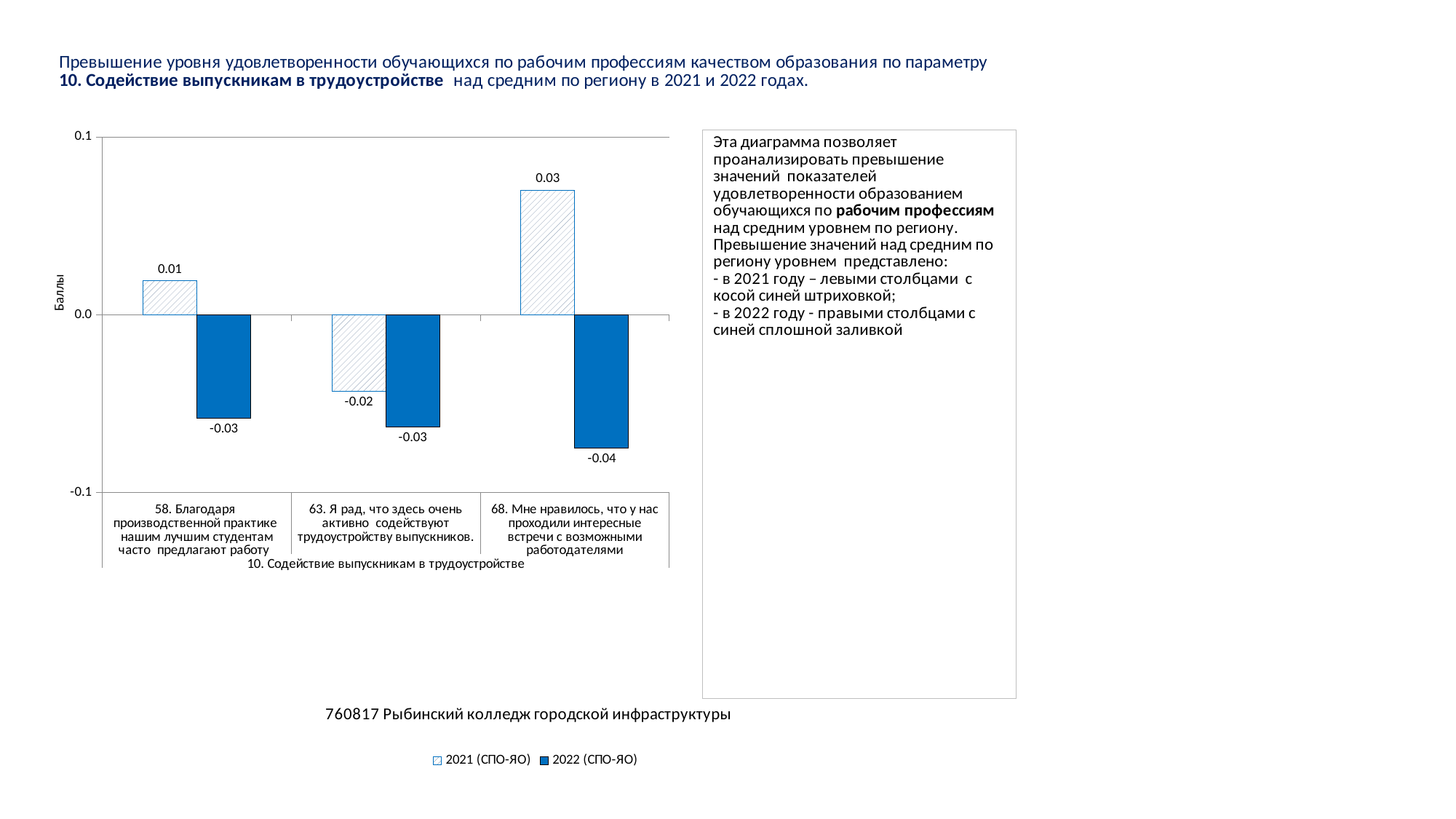
What type of chart is shown on the slide? Bar chart What is the difference between the 2021 and 2022 values for category 68? 0.07 For category 63, which series has the larger value, 2021 (СПО-ЯО) or 2022 (СПО-ЯО)? 2021 (СПО-ЯО) What is the value for 2022 (СПО-ЯО) for category 68 (Мне нравилось, что у нас проходили интересные встречи с возможными работодателями)? -0.04 Which category has the highest value for the 2021 (СПО-ЯО) series? 68. Мне нравилось, что у нас проходили интересные встречи с возможными работодателями How many categories are shown on the x axis of the chart? 3 What is the value for 2021 (СПО-ЯО) for category 58 (Благодаря производственной практике нашим лучшим студентам часто предлагают работу)? 0.01 What is the label of the vertical axis of the chart? Баллы What is the value for 2022 (СПО-ЯО) for category 58? -0.03 How many series does the chart legend list? 2 Which category has the lowest value for the 2022 (СПО-ЯО) series? 68. Мне нравилось, что у нас проходили интересные встречи с возможными работодателями What is the value for 2021 (СПО-ЯО) for category 63 (Я рад, что здесь очень активно содействуют трудоустройству выпускников)? -0.02